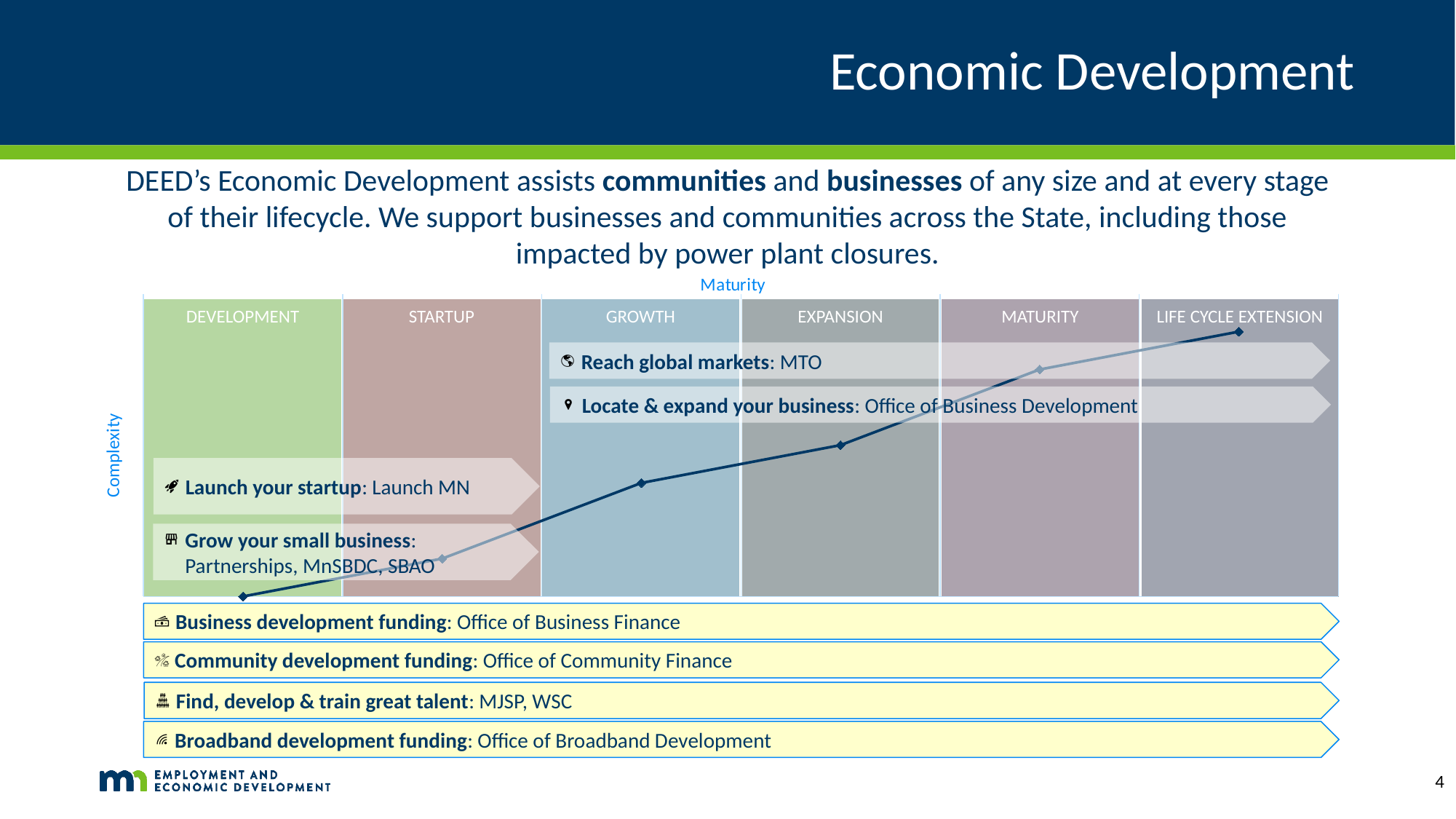
What is the label of the x axis of the chart? Maturity At which stage does the line reach its highest point? Life Cycle Extension What is the label of the y axis of the chart? Complexity At which stage is the line at its lowest point? Development Is the line higher at Startup or at Maturity? Maturity How many lifecycle stages are shown along the x axis of the chart? 6 Which stage comes immediately after Startup on the x axis? Growth Is the line higher at Expansion or at Growth? Expansion Does the line rise or fall as it moves from Development to Life Cycle Extension? rises What kind of chart is overlaid on the lifecycle diagram? line chart